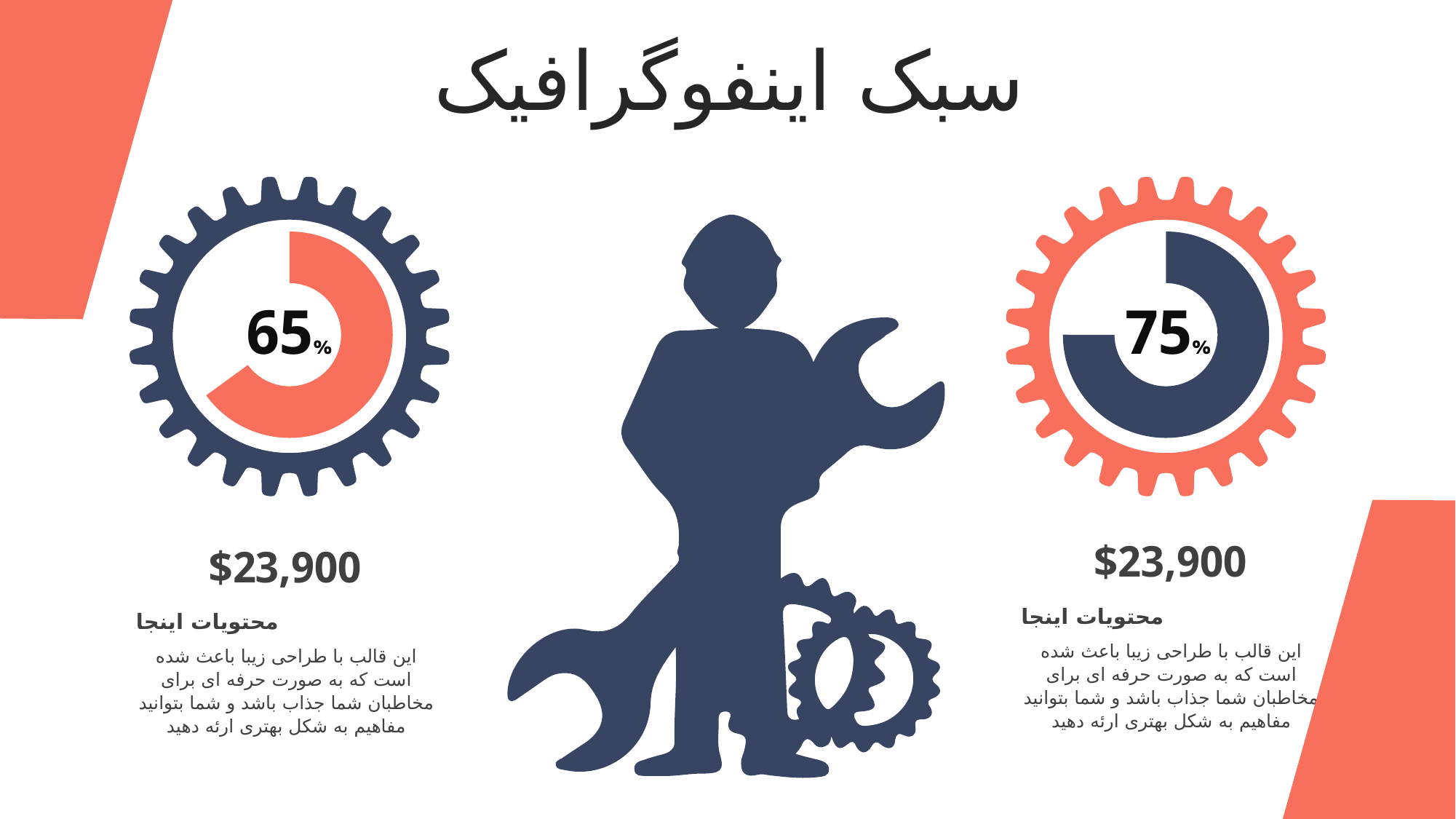
What colour is the filled portion of the right donut chart? dark blue Is the value in the left donut chart greater or less than 50%? greater What percentage is shown in the left donut chart? 65% What colour is the filled portion of the left donut chart? coral/orange What percentage is shown in the right donut chart? 75% What dollar amount is printed below the left donut chart? $23,900 How many donut charts are on the slide? 2 What dollar amount is printed below the right donut chart? $23,900 What is the difference in percentage points between the right donut chart and the left donut chart? 10 What kind of chart is used to display the 65% value on the left? donut chart Which donut chart shows the higher percentage, the left one or the right one? the right one Which donut chart shows the lowest percentage? the left one (65%)